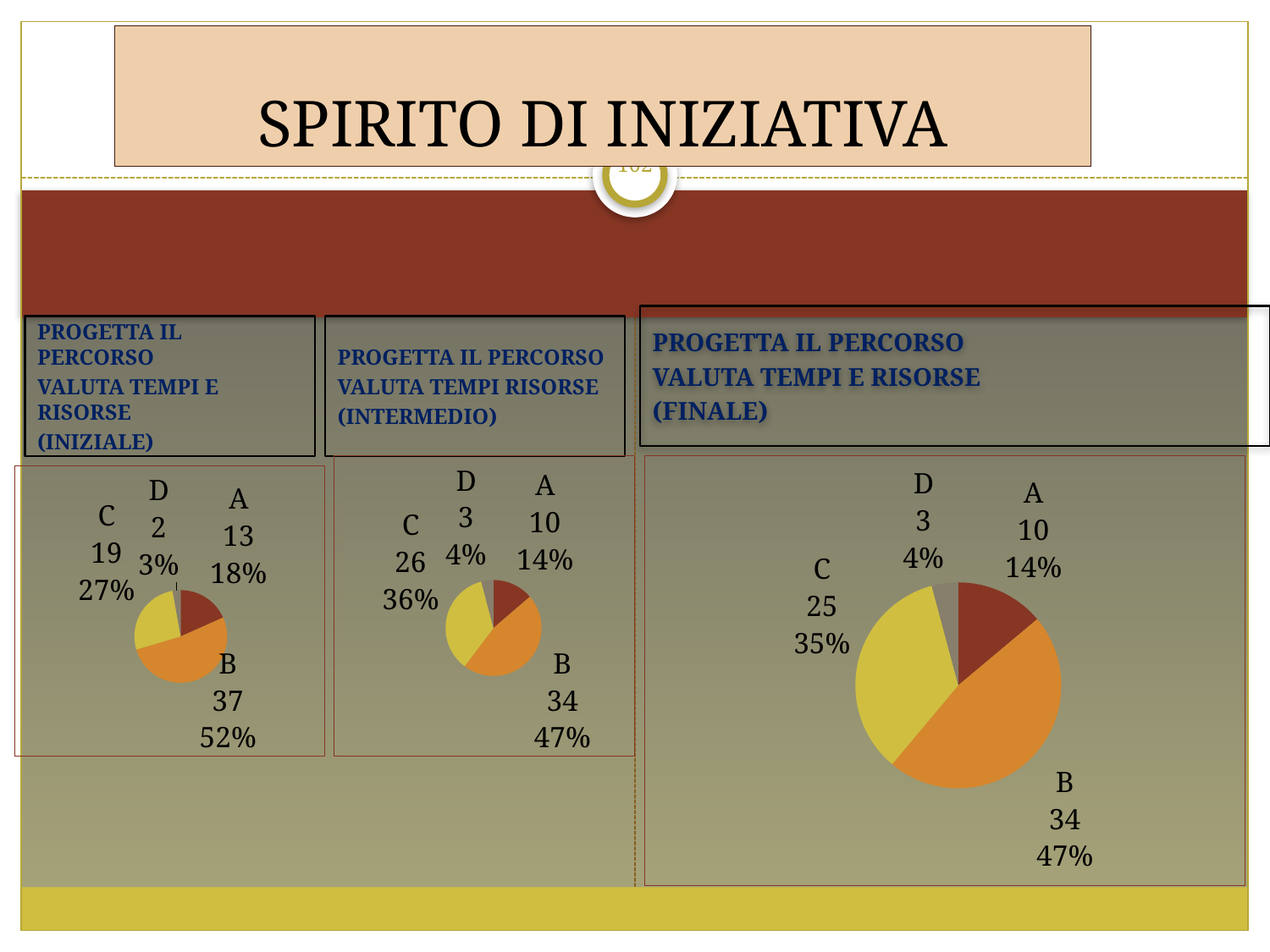
In the right pie chart (FINALE), which is larger, the value for B or the value for C? B How many categories are shown in the right pie chart (FINALE)? 4 What type of chart is used on this slide? Pie chart In the left pie chart (INIZIALE), which category has the smallest value? D In the left pie chart (INIZIALE), what percentage share does category C have? 27% In the right pie chart (FINALE), what percentage share does category C have? 35% What is the difference between the value for C in the middle chart (INTERMEDIO) and the value for C in the right chart (FINALE)? 1 In the middle pie chart (INTERMEDIO), which category has the largest share? B In the middle pie chart (INTERMEDIO), what is the difference between the values for B and A? 24 In the right pie chart (FINALE), what is the value for category D? 3 In the middle pie chart (INTERMEDIO), what is the value for category C? 26 In the left pie chart (INIZIALE), what is the value for category B? 37